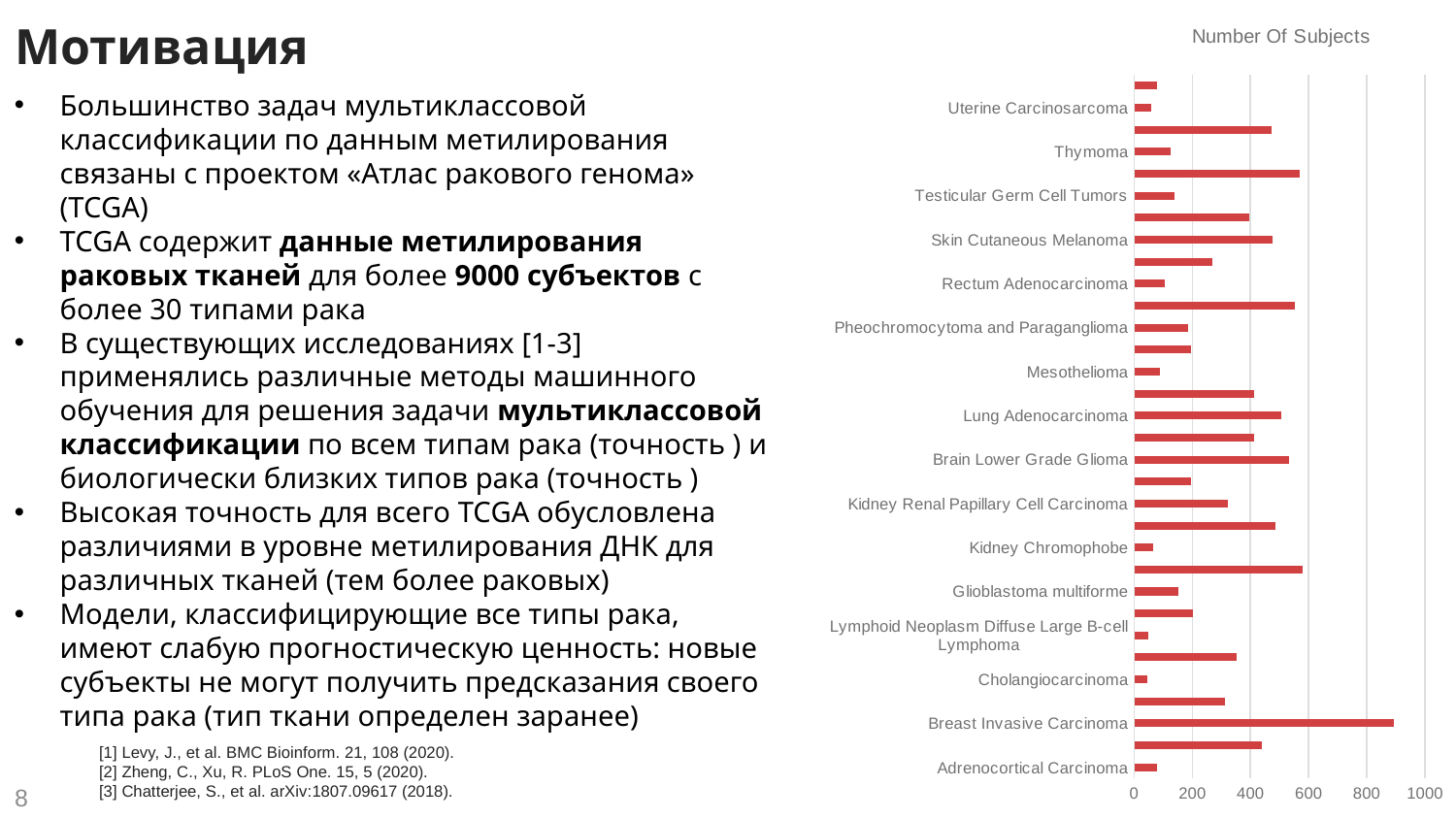
What is the maximum value shown on the horizontal axis of the chart? 1000 Is the value for Kidney Renal Papillary Cell Carcinoma greater or less than 200? greater Which labeled category has the highest number of subjects? Breast Invasive Carcinoma Is the value for Cholangiocarcinoma greater or less than 200? less Which has more subjects, Lung Adenocarcinoma or Mesothelioma? Lung Adenocarcinoma Is the value for Brain Lower Grade Glioma greater or less than 400? greater Which has more subjects, Breast Invasive Carcinoma or Thymoma? Breast Invasive Carcinoma What kind of chart is shown on the slide? bar chart What is the title of the chart? Number Of Subjects